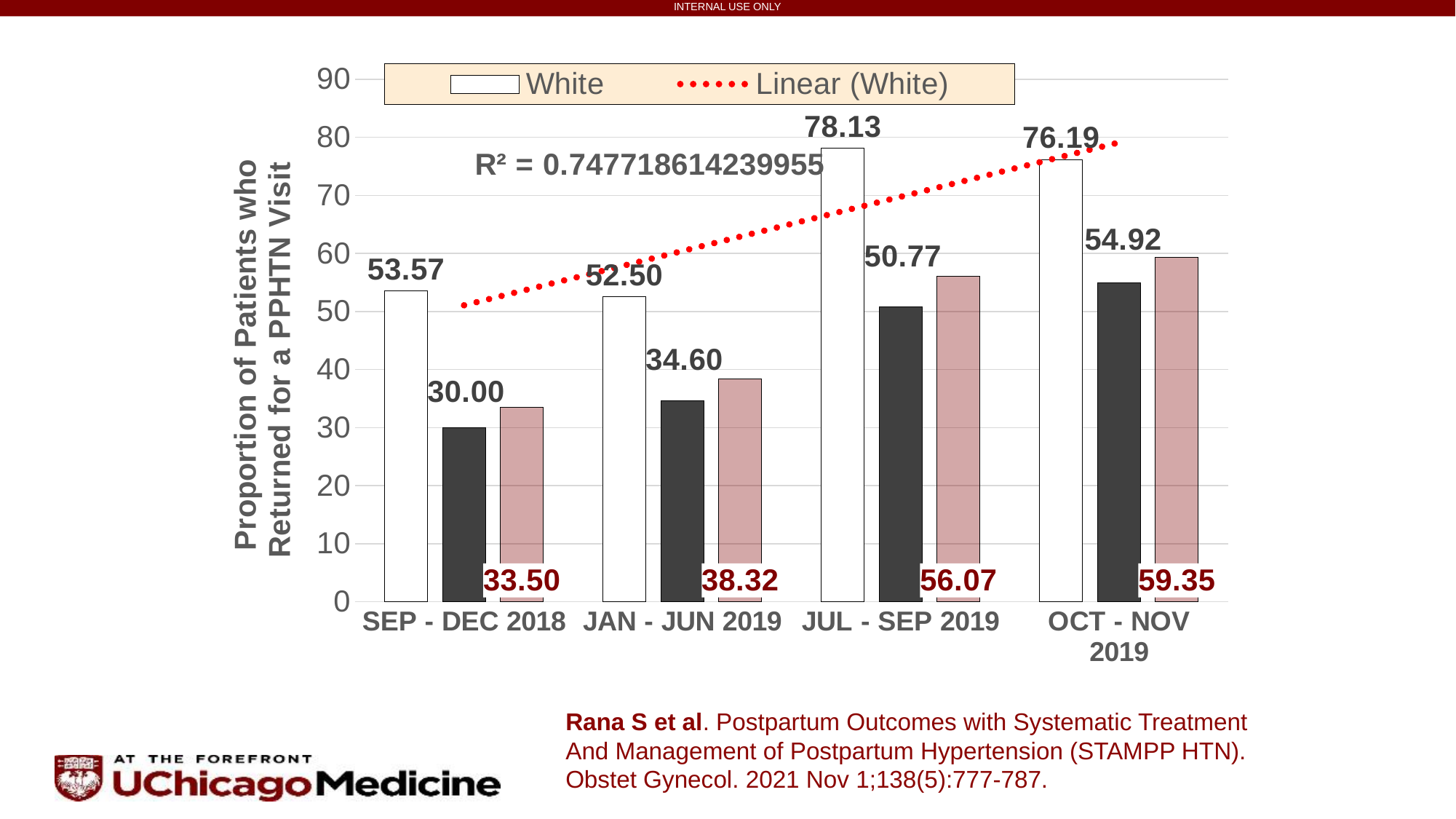
What is the value of the White series for OCT - NOV 2019? 76.19 What is the R² value printed on the chart? 0.747718614239955 What is the difference between the White series values for JUL - SEP 2019 and SEP - DEC 2018? 24.56 What is the value of the White series for SEP - DEC 2018? 53.57 What kind of chart is shown on the slide? Bar chart Which period has the larger White series value, JUL - SEP 2019 or OCT - NOV 2019? JUL - SEP 2019 What is the value of the White series for JUL - SEP 2019? 78.13 How many entries does the legend list? 2 How many time periods are shown on the x axis? 4 In which period is the White series highest? JUL - SEP 2019 In which period is the White series lowest? JAN - JUN 2019 What is the title of the y axis? Proportion of Patients who Returned for a PPHTN Visit